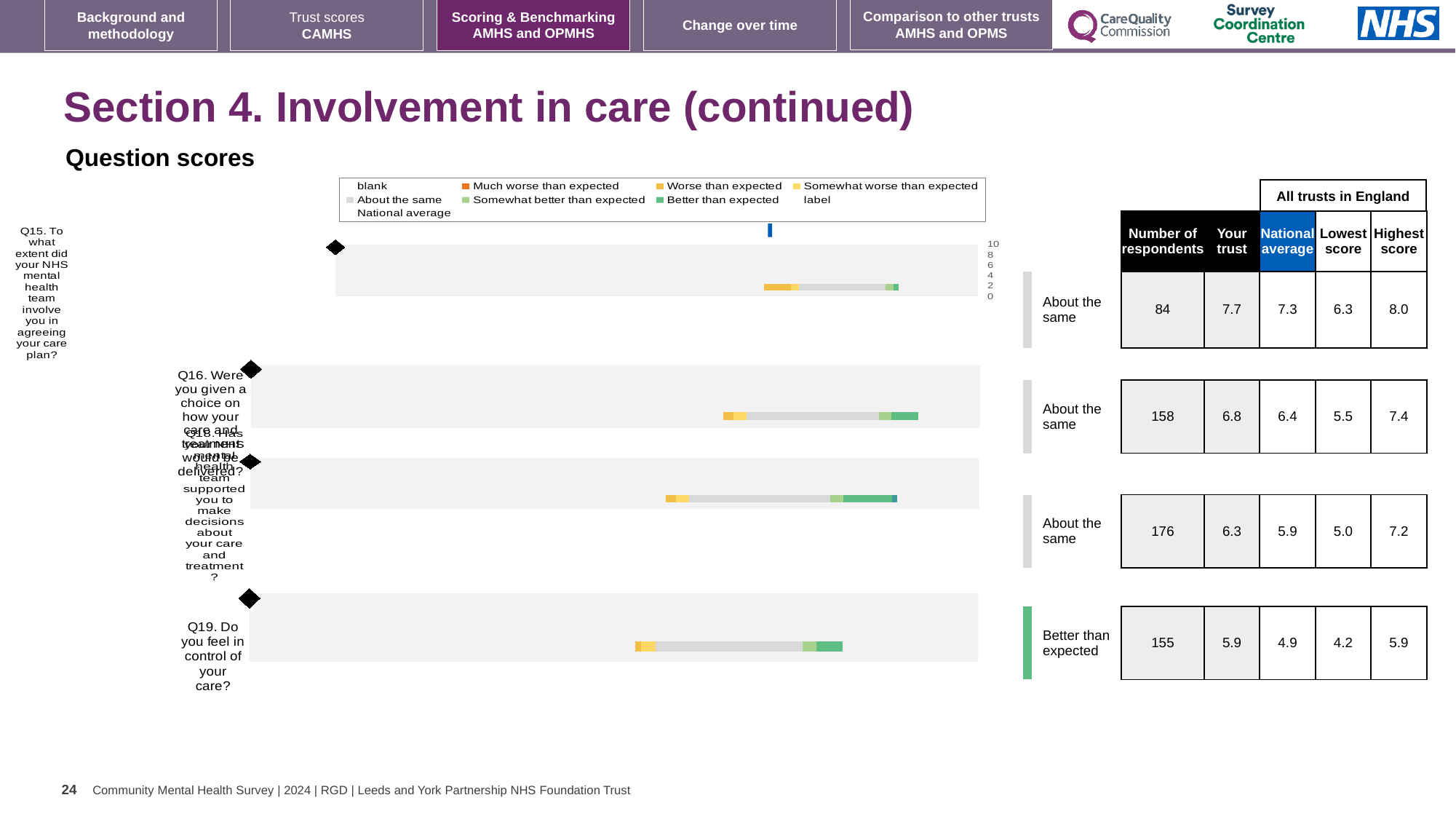
Which question has the highest 'Your trust' score? Q15 What is the highest score among all trusts in England for Q19 (feeling in control of your care)? 5.9 How many respondents answered Q18 (supported to make decisions about care and treatment)? 176 What is the lowest score among all trusts in England for Q18? 5.0 How many questions (categories) are plotted in the question scores chart? 4 What is the 'Your trust' score for Q15 (involving you in agreeing your care plan)? 7.7 What is the national average score for Q16 (choice on how care and treatment would be delivered)? 6.4 Which question has the lowest 'Your trust' score? Q19 For Q16, which is larger: the 'Your trust' score or the national average? Your trust What kind of chart is used to show the question scores on this slide? bar chart For Q19, how much higher is the 'Your trust' score than the national average? 1.0 Which question is rated 'Better than expected' rather than 'About the same'? Q19